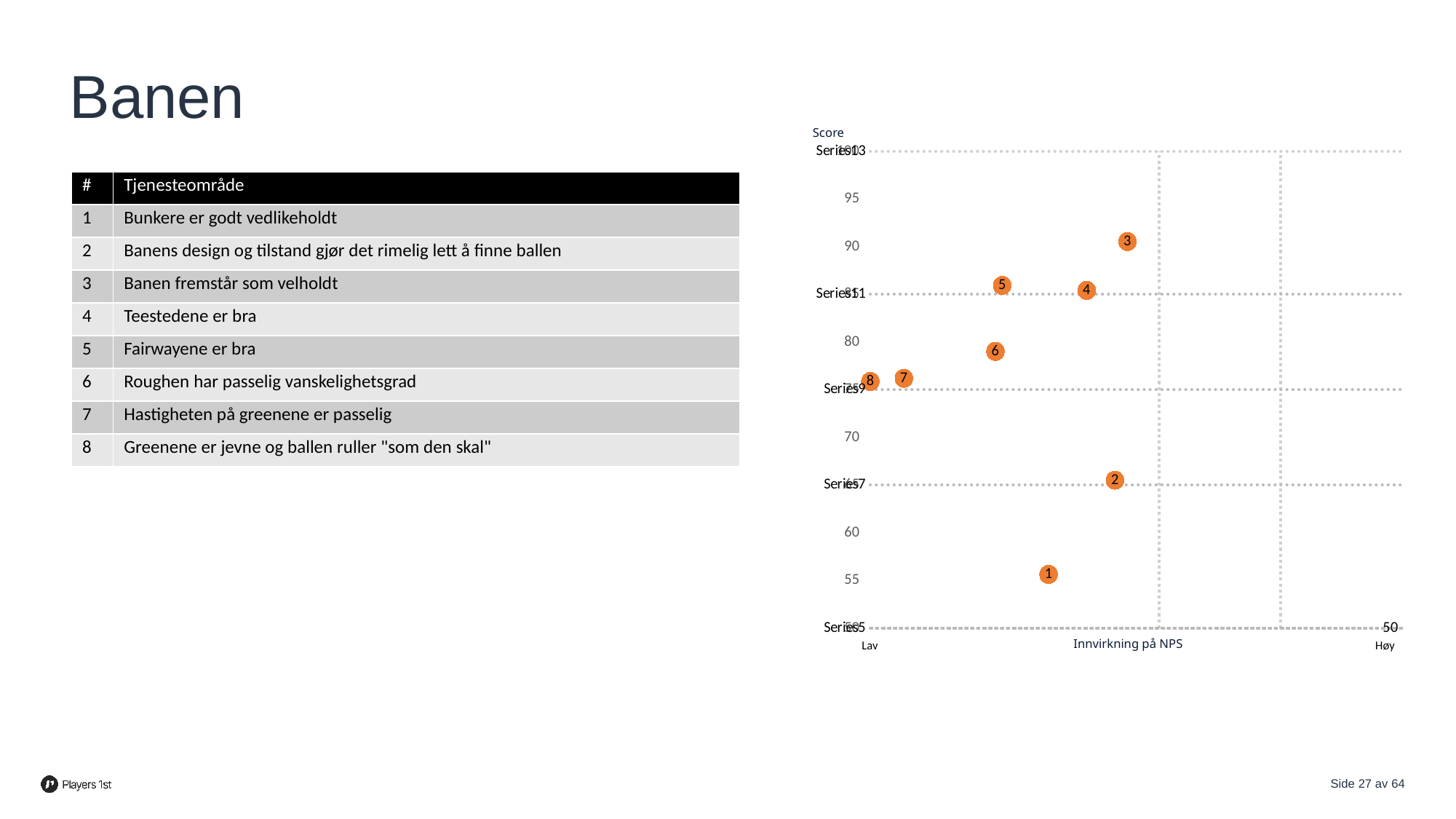
Which numbered point is furthest to the left on the chart (lowest impact on NPS)? 8 Which has a higher score on the chart, point 2 or point 6? point 6 Is the score for point 6 greater or less than 75? greater Is the score for point 3 greater or less than 85? greater What is the title of the horizontal axis of the chart? Innvirkning på NPS Is the score for point 2 greater or less than 70? less How many numbered points are plotted on the chart? 8 What is the title of the vertical axis of the chart? Score What kind of chart is shown on the slide? scatter chart Which numbered point has the highest score on the chart? 3 Which numbered point has the lowest score on the chart? 1